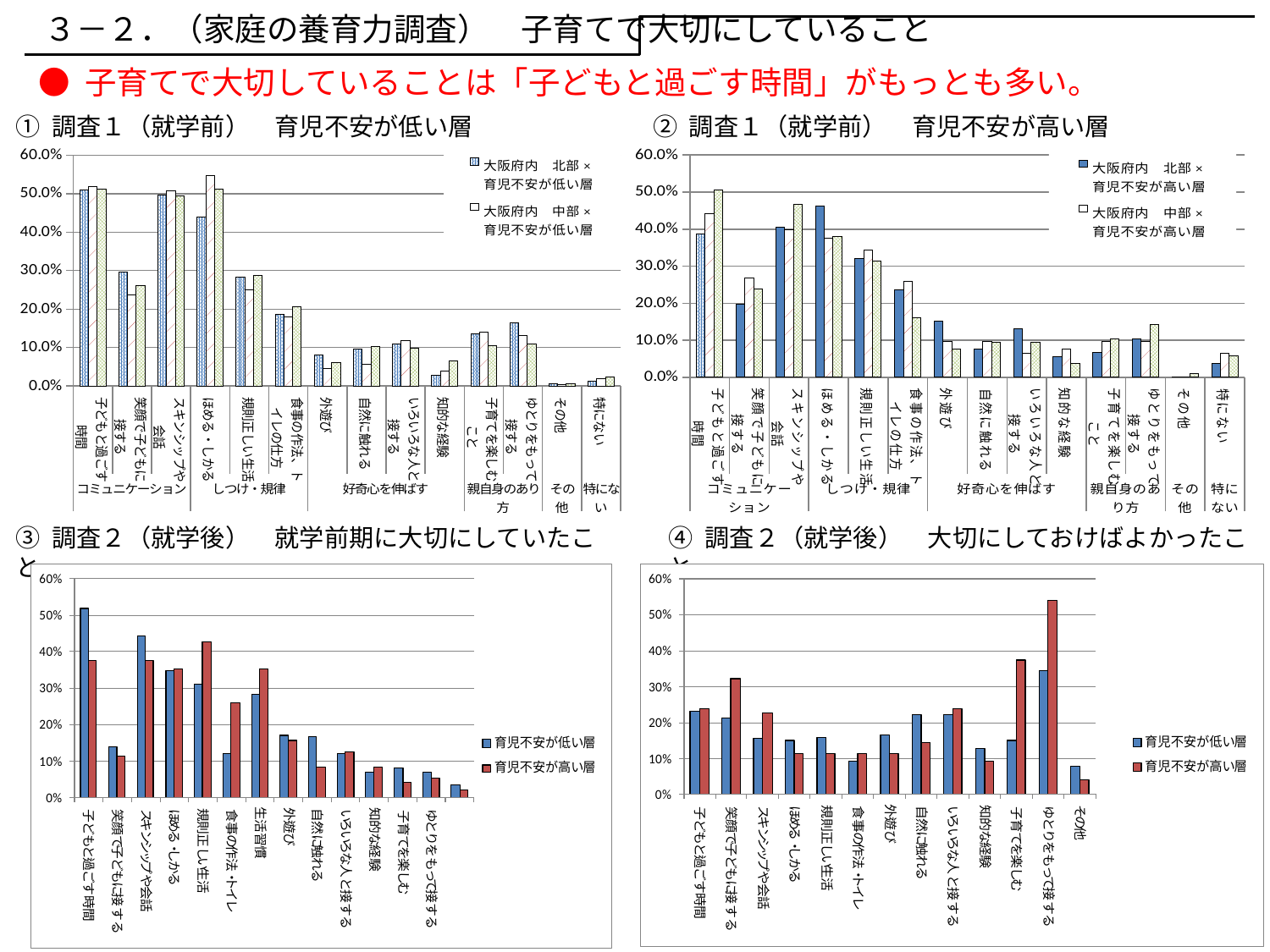
How many categories are shown on the x axis of chart ③ (調査２（就学後） 就学前期に大切にしていたこと)? 13 In chart ② (調査１（就学前） 育児不安が高い層), is the value for ほめる・しかる in the 大阪府内 北部×育児不安が高い層 series greater or less than 40%? greater How many series does the legend of chart ② (調査１（就学前） 育児不安が高い層) list? 2 In chart ③ (調査２（就学後） 就学前期に大切にしていたこと), which series has the larger value for 規則正しい生活? 育児不安が高い層 In chart ② (調査１（就学前） 育児不安が高い層), which category has the highest value for the 大阪府内 中部×育児不安が高い層 series? 子どもと過ごす時間 In chart ④ (調査２（就学後） 大切にしておけばよかったこと), which series has the larger value for 子育てを楽しむ? 育児不安が高い層 In chart ④ (調査２（就学後） 大切にしておけばよかったこと), which category has the highest value for 育児不安が高い層? ゆとりをもって接する In chart ③ (調査２（就学後） 就学前期に大切にしていたこと), is the value for 子どもと過ごす時間 in the 育児不安が低い層 series greater or less than 40%? greater In chart ③ (調査２（就学後） 就学前期に大切にしていたこと), which category has the highest value for 育児不安が低い層? 子どもと過ごす時間 What kind of chart is chart ④ (調査２（就学後） 大切にしておけばよかったこと)? bar chart In chart ④ (調査２（就学後） 大切にしておけばよかったこと), is the value for ゆとりをもって接する in the 育児不安が高い層 series greater or less than 50%? greater